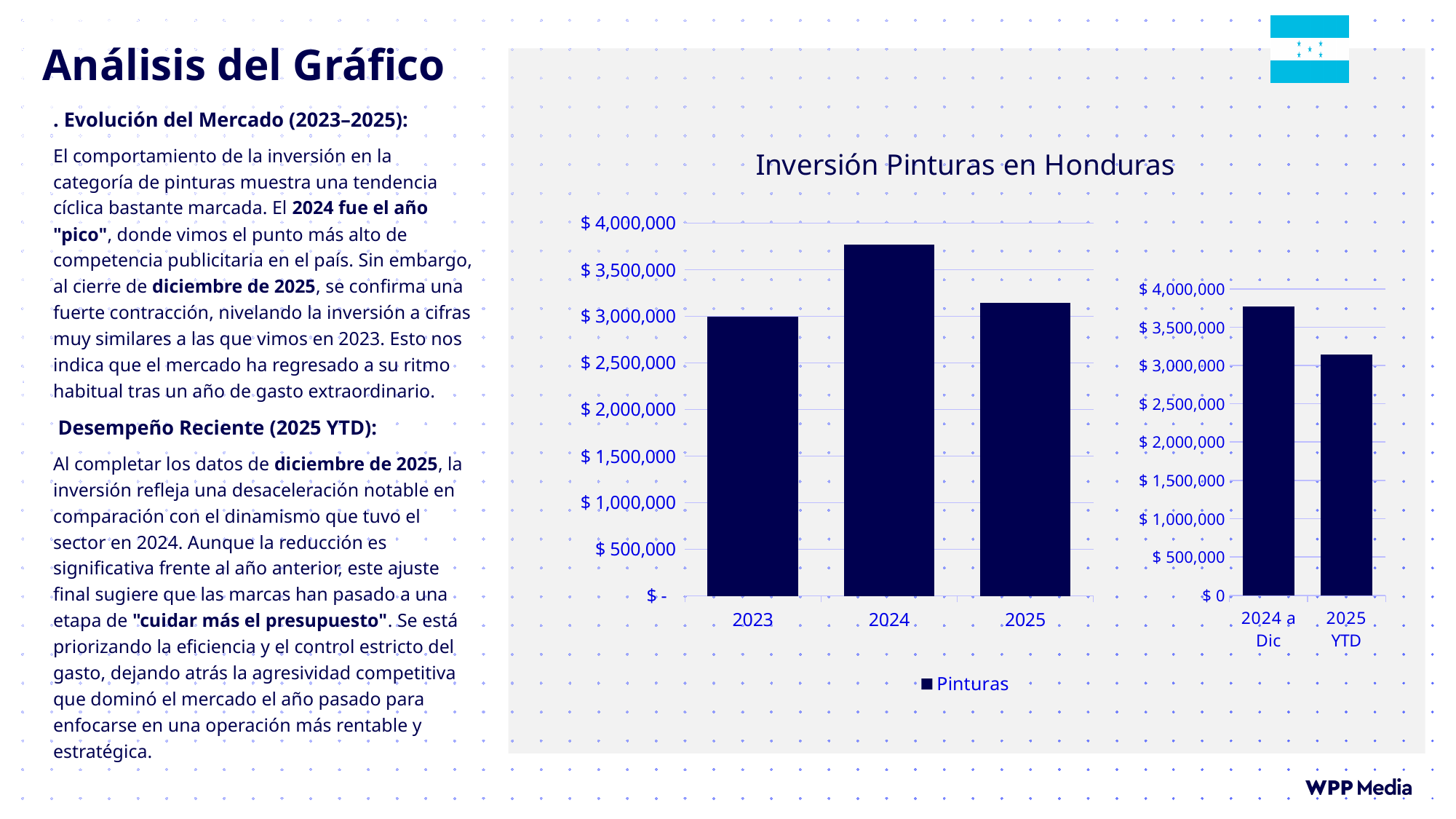
In the smaller chart on the right of the slide, which is larger, the value for '2024 a Dic' or the value for '2025 YTD'? 2024 a Dic In the 'Inversión Pinturas en Honduras' chart, is the value for 2025 greater or less than 3,000,000? greater In the 'Inversión Pinturas en Honduras' chart, which is larger, the value for 2024 or the value for 2025? 2024 In the 'Inversión Pinturas en Honduras' chart, is the value for 2023 greater or less than 3,500,000? less In the 'Inversión Pinturas en Honduras' chart, which year has the highest investment? 2024 In the 'Inversión Pinturas en Honduras' chart, is the value for 2024 greater or less than 3,500,000? greater In the 'Inversión Pinturas en Honduras' chart, which year has the lowest investment? 2023 What kind of chart is the 'Inversión Pinturas en Honduras' chart? bar chart In the 'Inversión Pinturas en Honduras' chart, do the values rise or fall from 2024 to 2025? fall How many series does the legend of the 'Inversión Pinturas en Honduras' chart list? 1 How many years are shown on the x axis of the 'Inversión Pinturas en Honduras' chart? 3